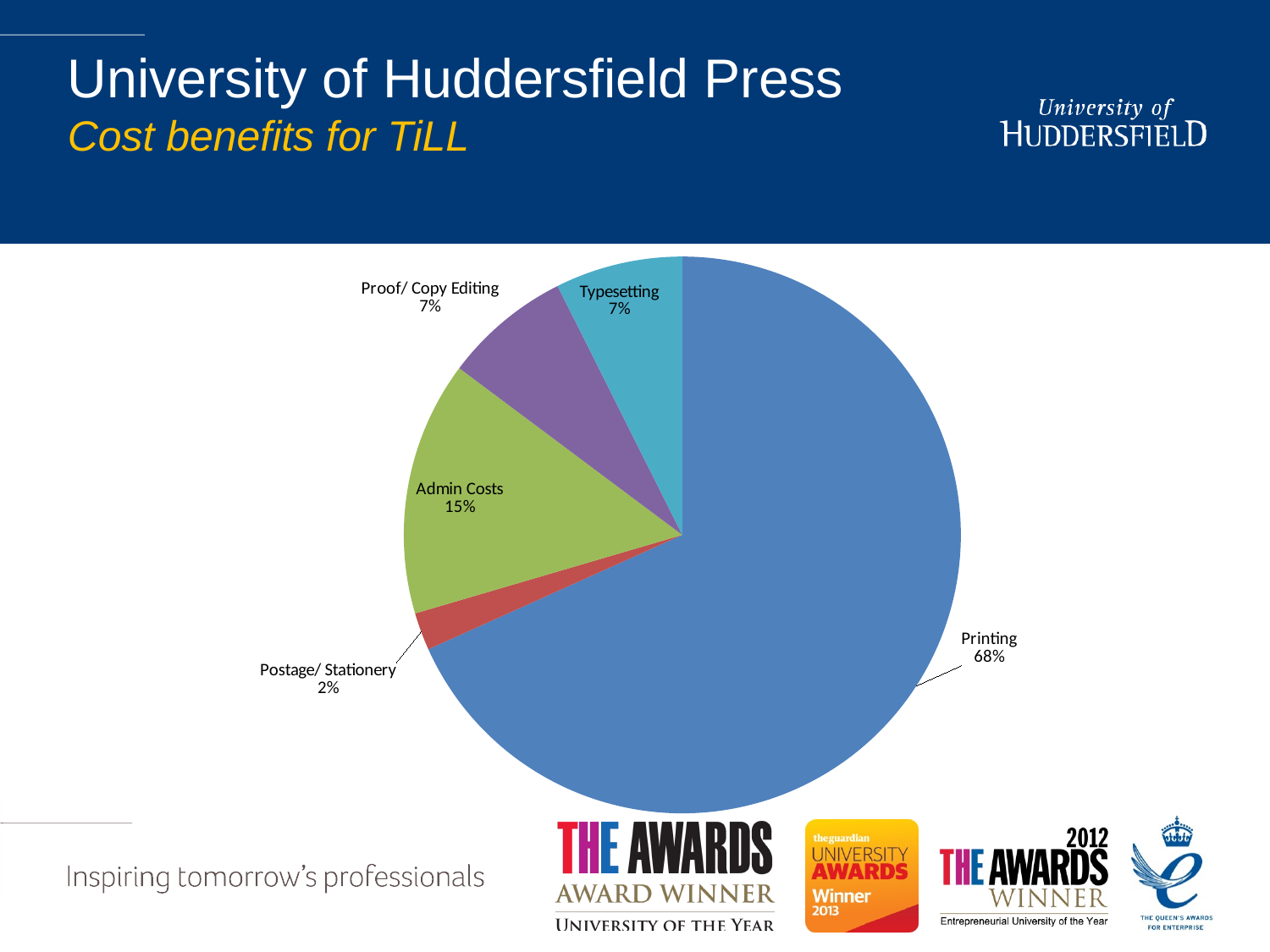
What is the difference in percentage points between Printing and Admin Costs? 53 What is the value shown for Admin Costs? 15% What is the value shown for Postage/ Stationery? 2% What share of the pie does Printing account for? 68% What is the difference in percentage points between Admin Costs and Postage/ Stationery? 13 What type of chart is shown on the slide? pie chart Which category has the largest slice of the pie? Printing How many categories are shown in the pie chart? 5 What colour is the Admin Costs slice? green What is the value shown for Typesetting? 7% Which category has the smallest slice of the pie? Postage/ Stationery Which is larger, Admin Costs or Proof/ Copy Editing? Admin Costs